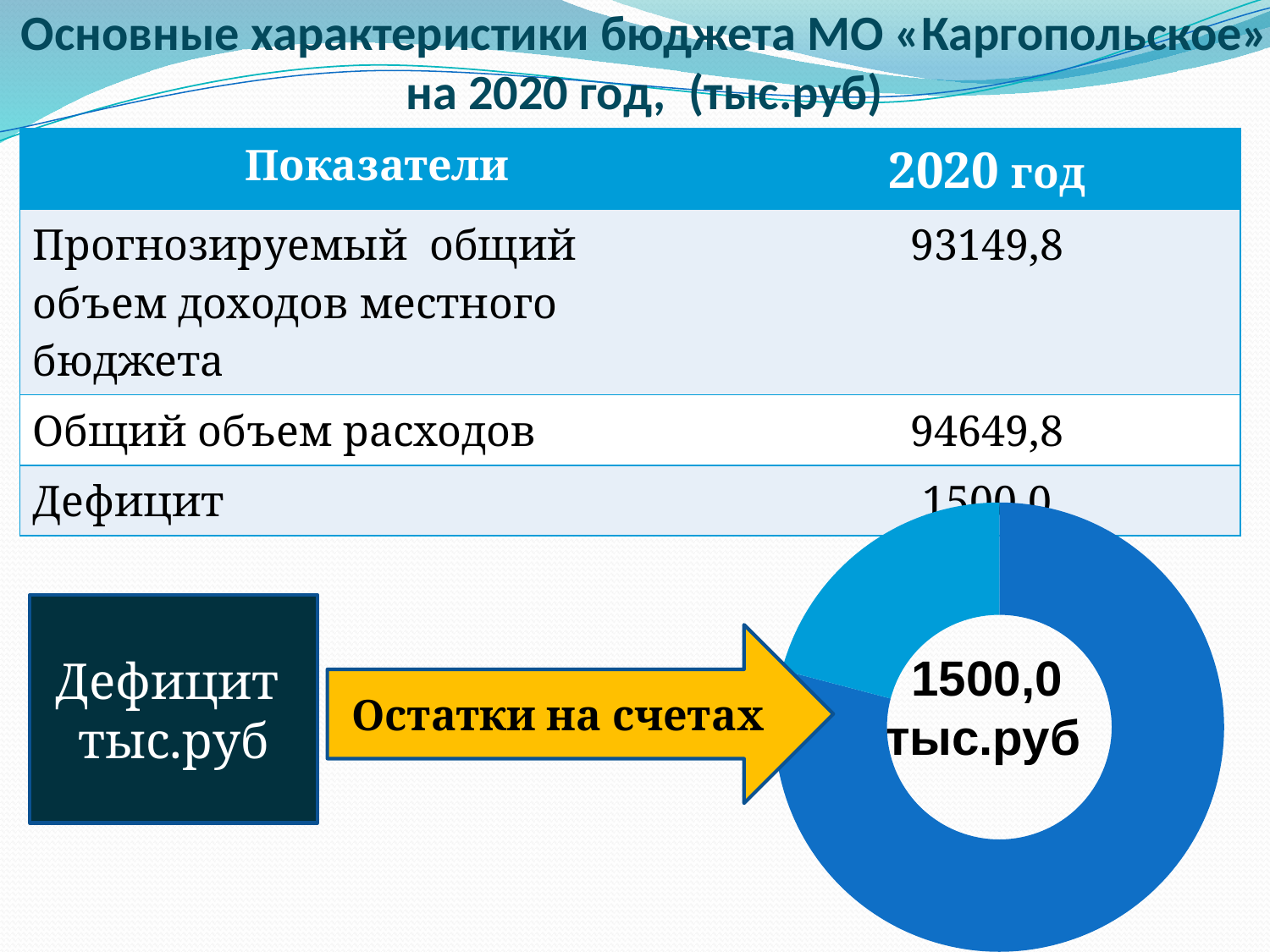
Does the doughnut chart have a legend? No What text is written on the yellow arrow pointing to the doughnut chart? Остатки на счетах What kind of chart is shown on the slide? doughnut chart What value is printed in the centre of the doughnut chart? 1500,0 тыс.руб Which slice of the doughnut chart is larger, the dark blue one or the light blue one? the dark blue one How many slices does the doughnut chart have? 2